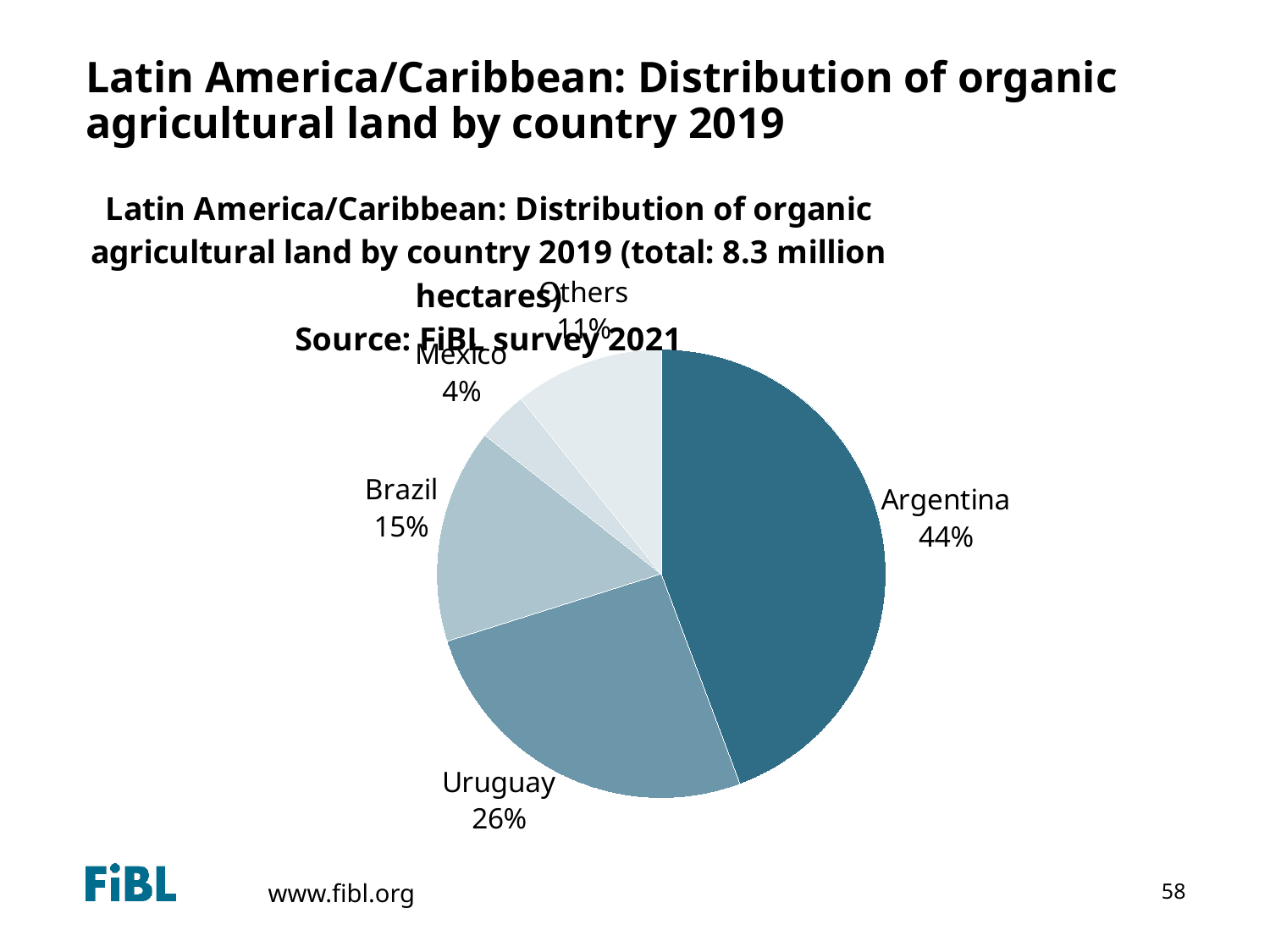
Which has a larger share, Brazil or Others? Brazil What percentage of the pie chart is Uruguay? 26% How many percentage points larger is Argentina's share than Uruguay's? 18 What share of organic agricultural land does Argentina hold in the pie chart? 44% According to the chart title, what is the total organic agricultural land in Latin America/Caribbean in 2019? 8.3 million hectares What percentage is shown for Mexico in the pie chart? 4% Which named slice is the smallest in the pie chart? Mexico What share is labelled for Others in the pie chart? 11% What type of chart is shown on the slide? Pie chart How many slices does the pie chart have? 5 What share does Brazil have in the pie chart? 15% Which country has the largest slice of the pie chart? Argentina